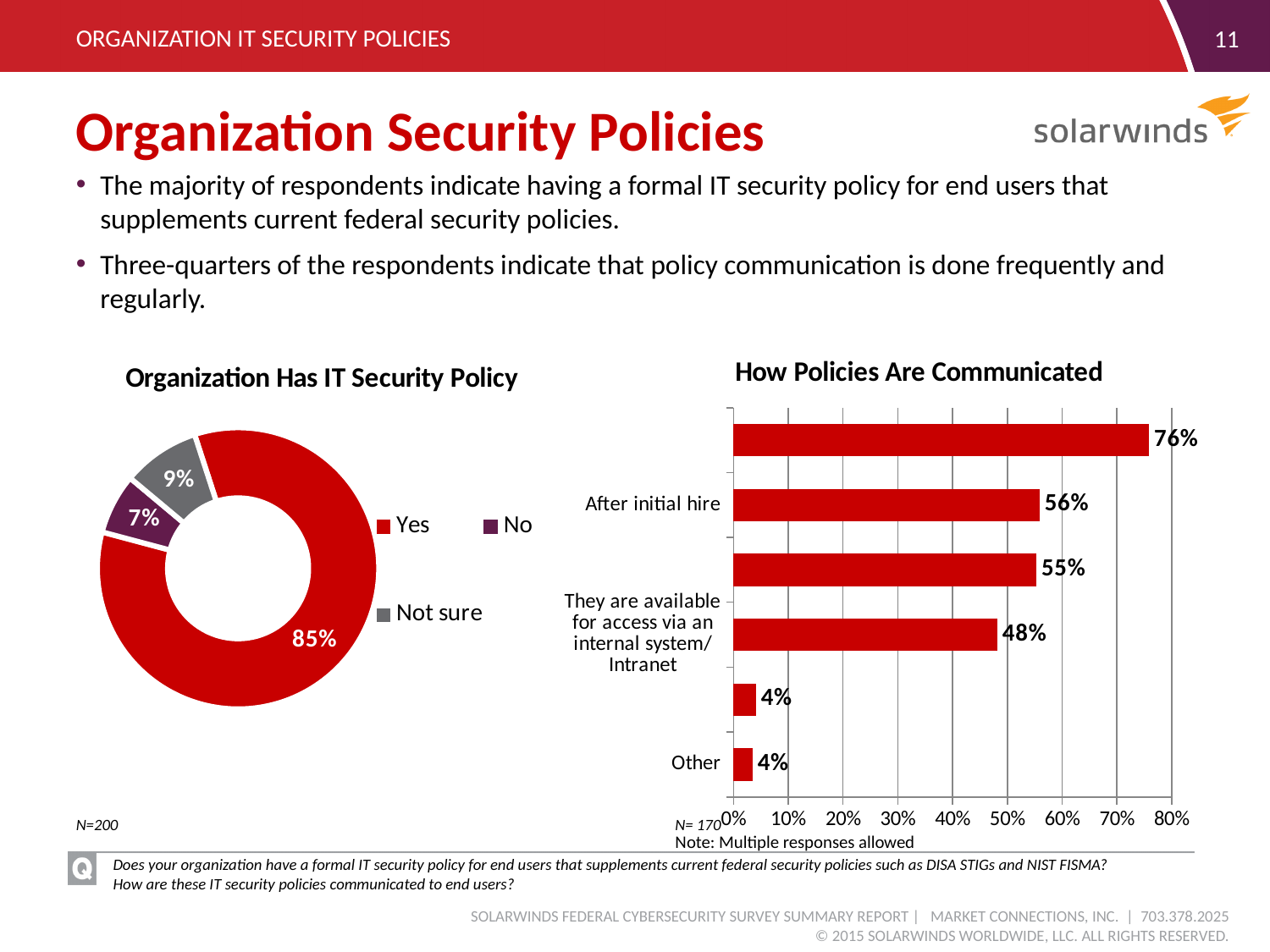
In the 'Organization Has IT Security Policy' chart, what percentage of respondents answered No? 7% In the 'Organization Has IT Security Policy' chart, which response has the smallest share? No In the 'How Policies Are Communicated' chart, what is the value for 'They are available for access via an internal system/Intranet'? 48% In the 'How Policies Are Communicated' chart, what is the value for 'After initial hire'? 56% In the 'How Policies Are Communicated' chart, what is the highest value shown on any bar? 76% In the 'Organization Has IT Security Policy' chart, how many entries does the legend list? 3 In the 'How Policies Are Communicated' chart, what is the difference between the values for 'After initial hire' and 'They are available for access via an internal system/Intranet'? 8 percentage points What kind of chart is 'Organization Has IT Security Policy'? Doughnut chart In the 'Organization Has IT Security Policy' chart, what percentage of respondents answered Yes? 85% How many bars are plotted in the 'How Policies Are Communicated' chart? 6 In the 'How Policies Are Communicated' chart, what is the value for 'Other'? 4% In the 'Organization Has IT Security Policy' chart, what percentage of respondents answered Not sure? 9%